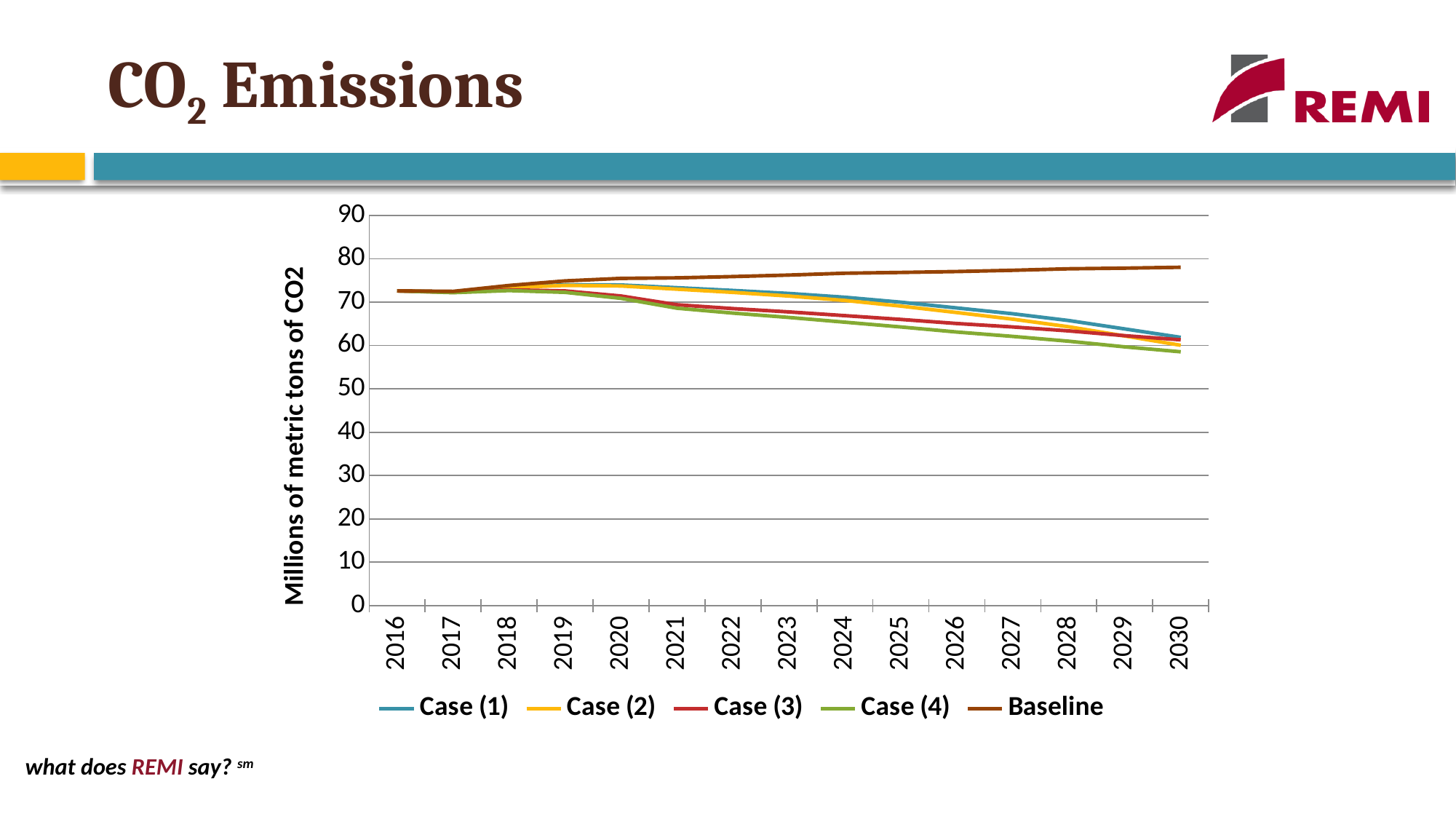
Is the Baseline value in 2030 greater or less than 70? greater Is the Case (4) value in 2030 greater or less than 70? less How many series does the legend list? 5 What is the label on the y axis? Millions of metric tons of CO2 Which series has the highest value in 2030? Baseline Which series has the lowest value in 2030? Case (4) Does the Baseline series rise or fall from 2016 to 2030? Rise Is the Baseline value in 2030 greater or less than 80? less In 2030, which is larger: the Baseline value or the Case (4) value? Baseline Does the Case (4) series rise or fall from 2020 to 2030? Fall What kind of chart is shown on the slide? Line chart How many years are shown along the x axis? 15